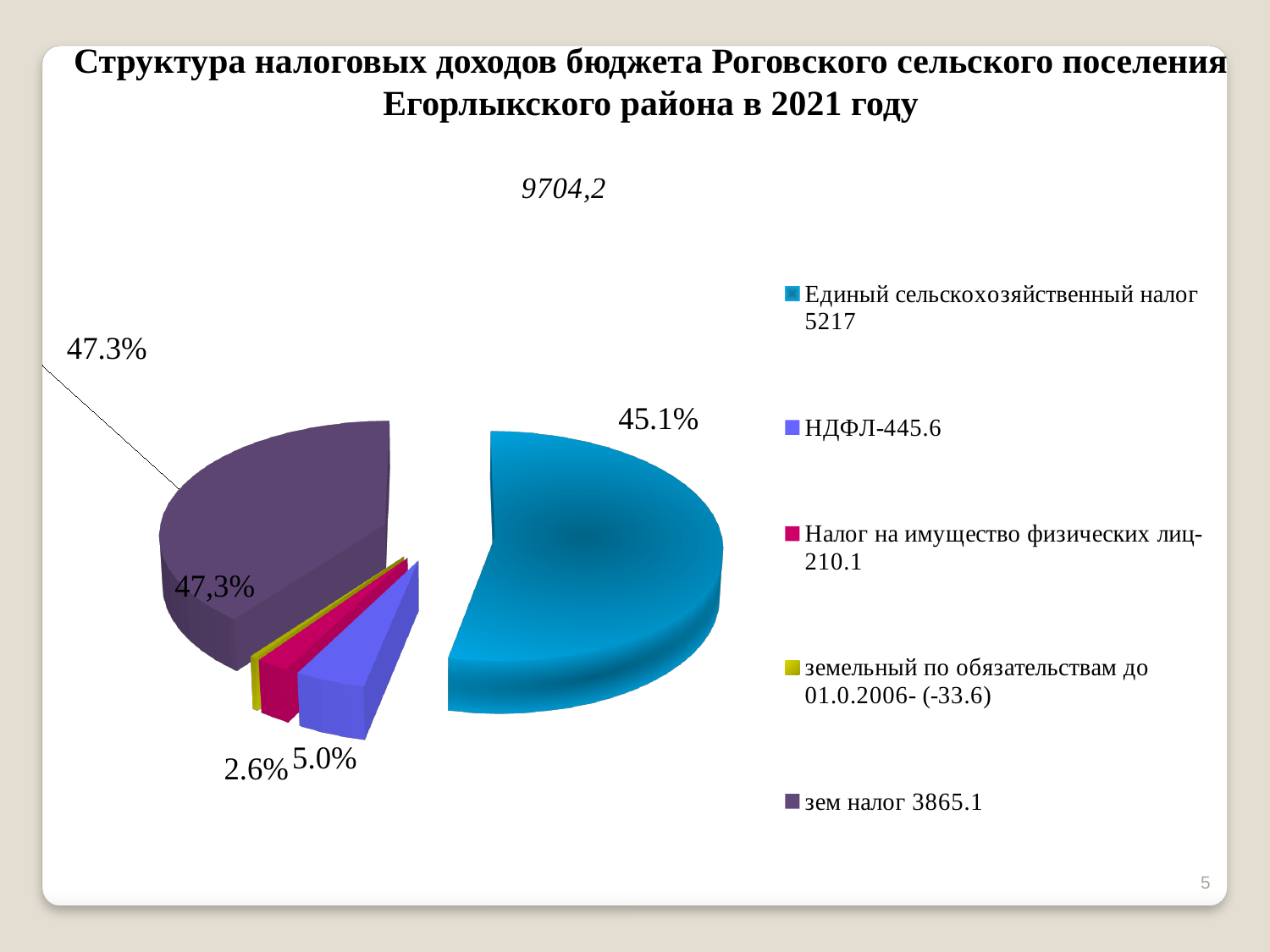
How many categories does the legend of the pie chart list? 5 What share of the pie is labelled for Налог на имущество физических лиц? 2.6% What share of the pie is labelled for НДФЛ? 5.0% What is the difference in percentage points between the share for зем налог (47.3%) and the share for Единый сельскохозяйственный налог (45.1%)? 2.2 What share of the pie is labelled for Единый сельскохозяйственный налог? 45.1% What is the title of the chart on the slide? 9704,2 What value is given in the legend for земельный по обязательствам до 01.0.2006? -33.6 Which category has the largest labelled share of the pie? зем налог What kind of chart is shown on the slide? Pie chart What value is given in the legend for НДФЛ? 445.6